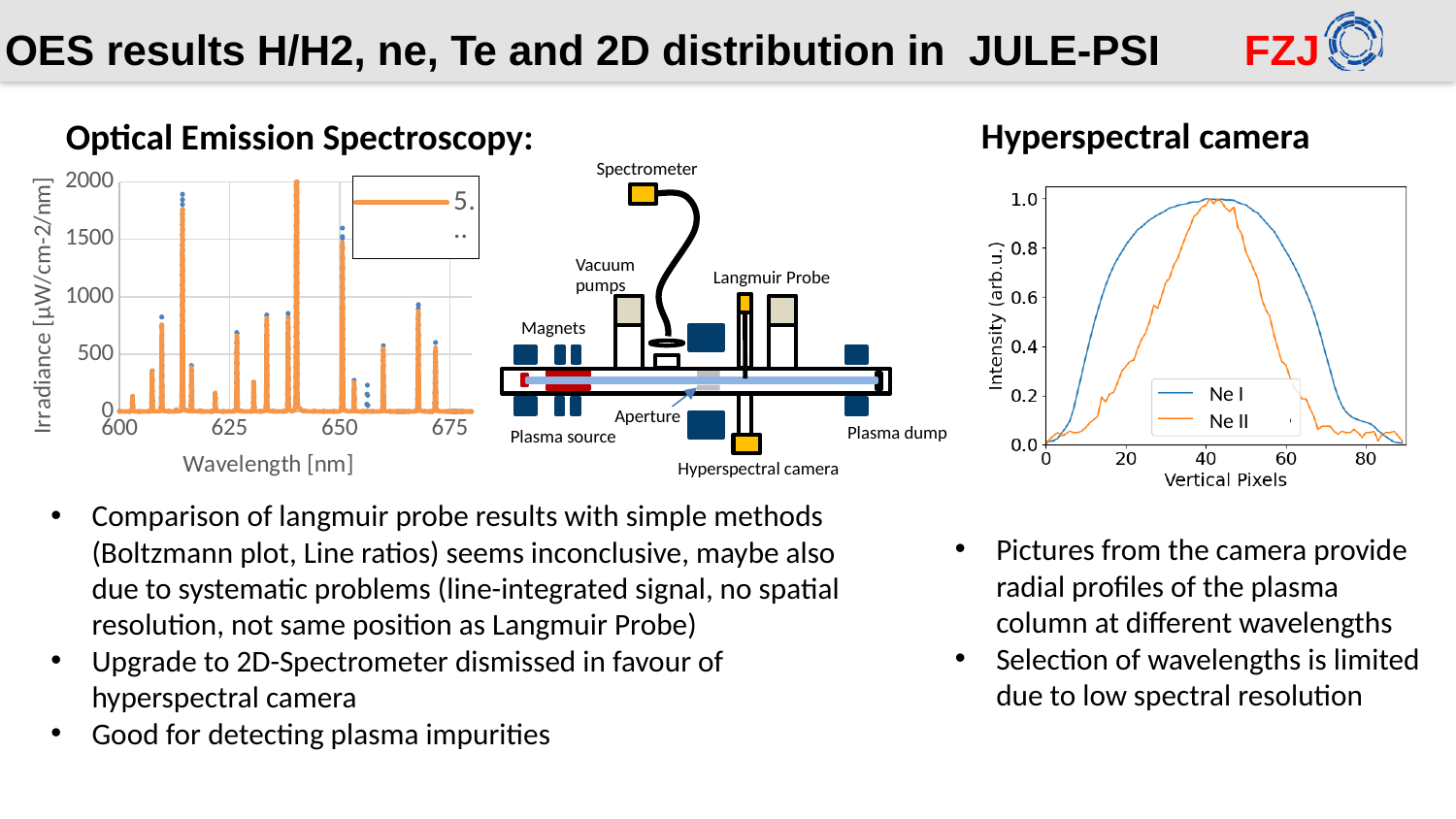
On the Optical Emission Spectroscopy chart, is the tallest peak (near 640 nm) greater or less than 1500? greater On the Hyperspectral camera chart, is the Ne I intensity at vertical pixel 60 greater or less than 0.4? greater On the Optical Emission Spectroscopy chart, is the peak near 650 nm greater or less than 1000? greater What kind of chart is the Hyperspectral camera chart? line chart On the Hyperspectral camera chart, what are the two series named in the legend? Ne I and Ne II On the Hyperspectral camera chart, what is the peak intensity value reached by the curves? 1.0 On the Hyperspectral camera chart, how many series does the legend list? 2 On the Hyperspectral camera chart, does the Ne I intensity rise or fall between vertical pixel 0 and vertical pixel 40? rise On the Optical Emission Spectroscopy chart, what is the label of the y axis? Irradiance [µW/cm-2/nm] On the Hyperspectral camera chart, at vertical pixel 20, which series has the higher intensity, Ne I or Ne II? Ne I